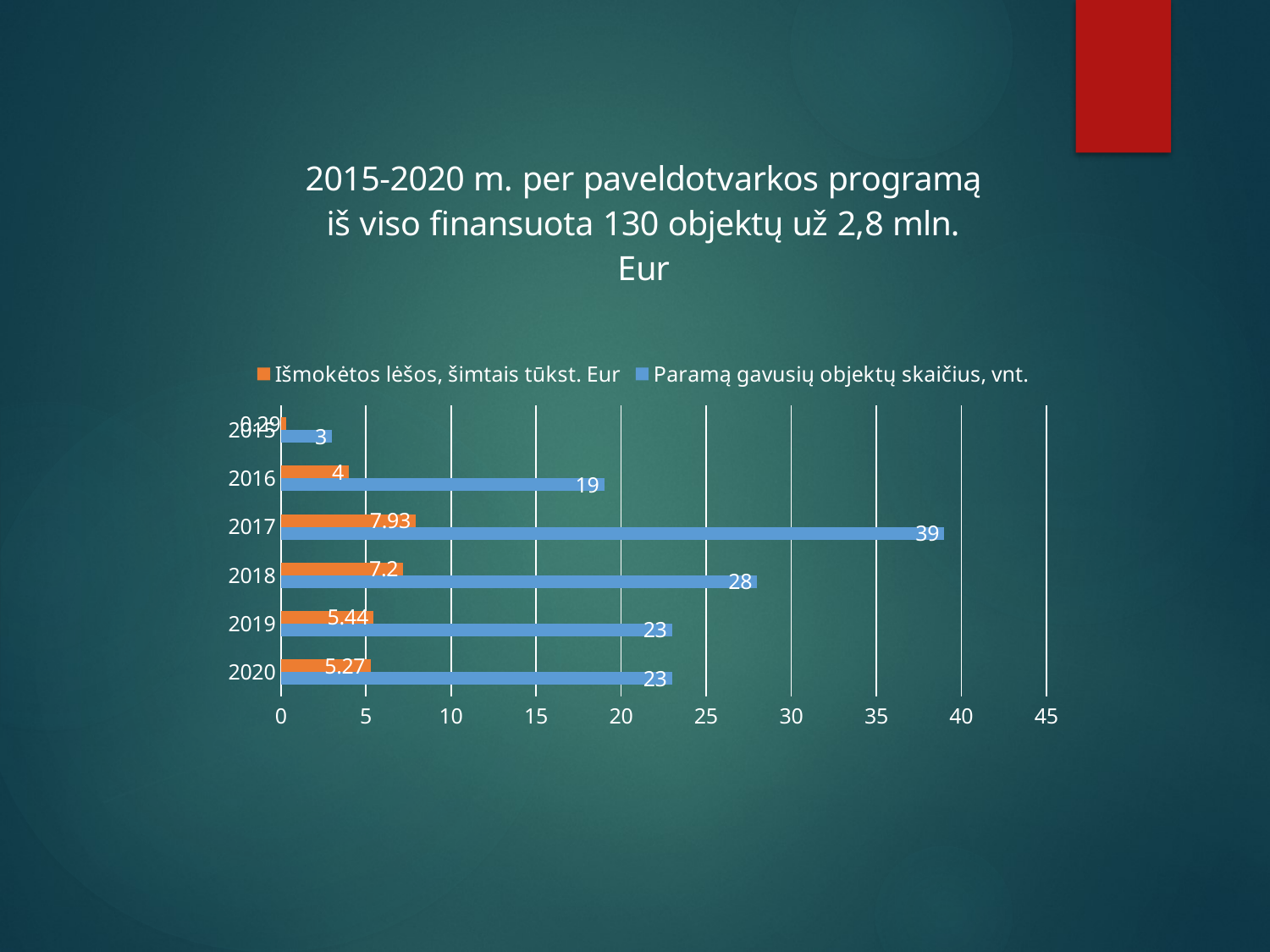
How many series does the legend list? 2 What is the value of 'Išmokėtos lėšos, šimtais tūkst. Eur' for 2018? 7.2 What is the title of the chart? 2015-2020 m. per paveldotvarkos programą iš viso finansuota 130 objektų už 2,8 mln. Eur What is the value of 'Paramą gavusių objektų skaičius, vnt.' for 2016? 19 Which year has the highest value for 'Paramą gavusių objektų skaičius, vnt.'? 2017 Which year has the lowest value for 'Paramą gavusių objektų skaičius, vnt.'? 2015 What type of chart is shown on the slide? bar chart Is the value of 'Paramą gavusių objektų skaičius, vnt.' for 2018 greater or less than 25? greater What is the value of 'Paramą gavusių objektų skaičius, vnt.' for 2017? 39 Which is larger: 'Išmokėtos lėšos, šimtais tūkst. Eur' for 2019 or for 2020? 2019 How many years (categories) are shown on the chart? 6 What is the difference between the 'Paramą gavusių objektų skaičius, vnt.' values for 2017 and 2018? 11